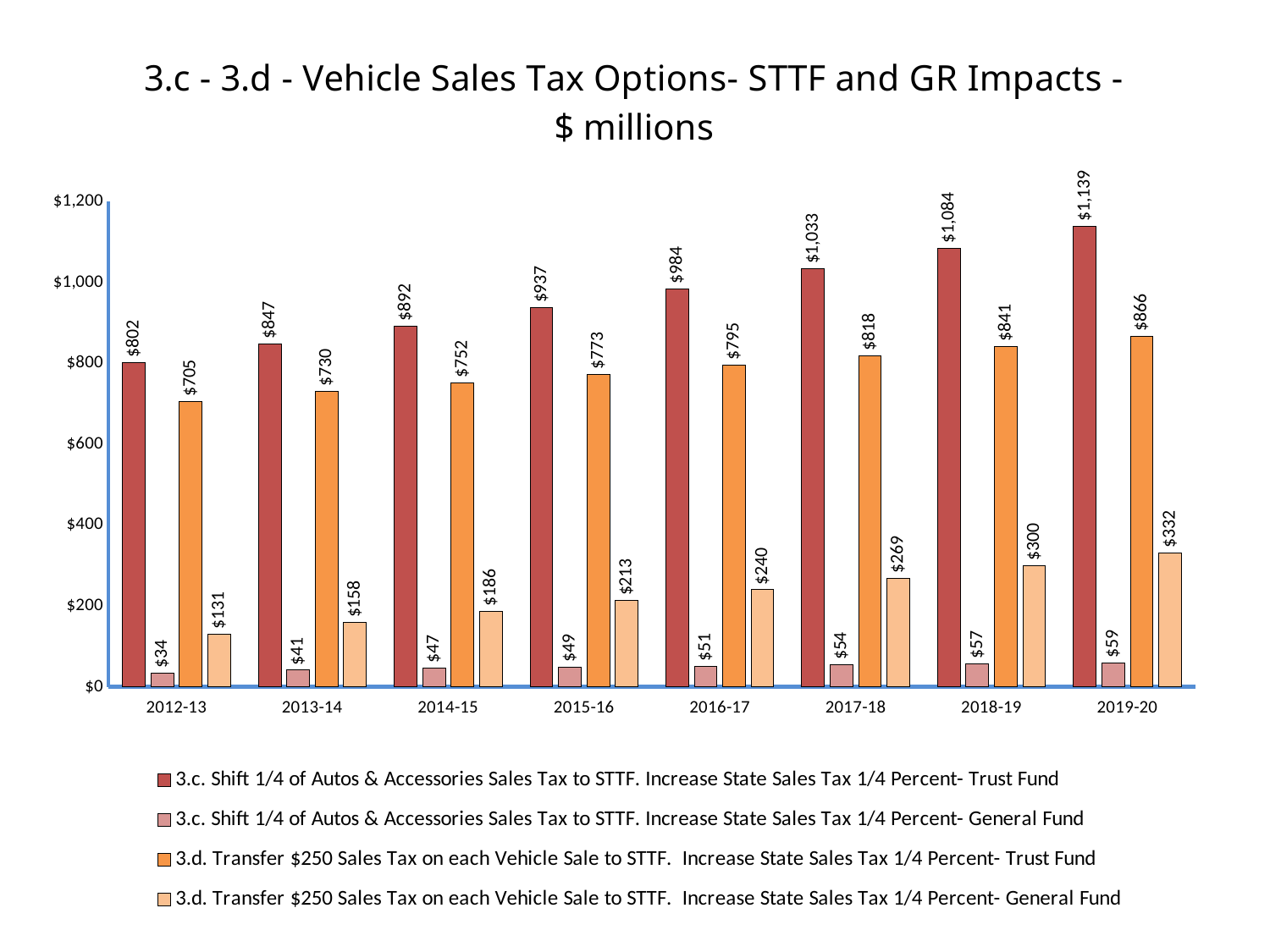
What is the value of the 3.c Trust Fund series for 2012-13? $802 How many series does the legend list? 4 What is the difference between the 3.c Trust Fund value and the 3.d Trust Fund value in 2019-20? $273 What is the value of the 3.d Trust Fund series for 2015-16? $773 In which year is the 3.d General Fund series lowest? 2012-13 How many fiscal years are shown on the x axis? 8 What is the value of the 3.d General Fund series for 2019-20? $332 What is the value of the 3.c General Fund series for 2017-18? $54 Which is larger in 2014-15: the 3.c Trust Fund value or the 3.d Trust Fund value? 3.c Trust Fund ($892) What kind of chart is shown on the slide? Bar chart Does the 3.d General Fund series rise or fall from 2012-13 to 2019-20? Rise In which year is the 3.c Trust Fund series highest? 2019-20